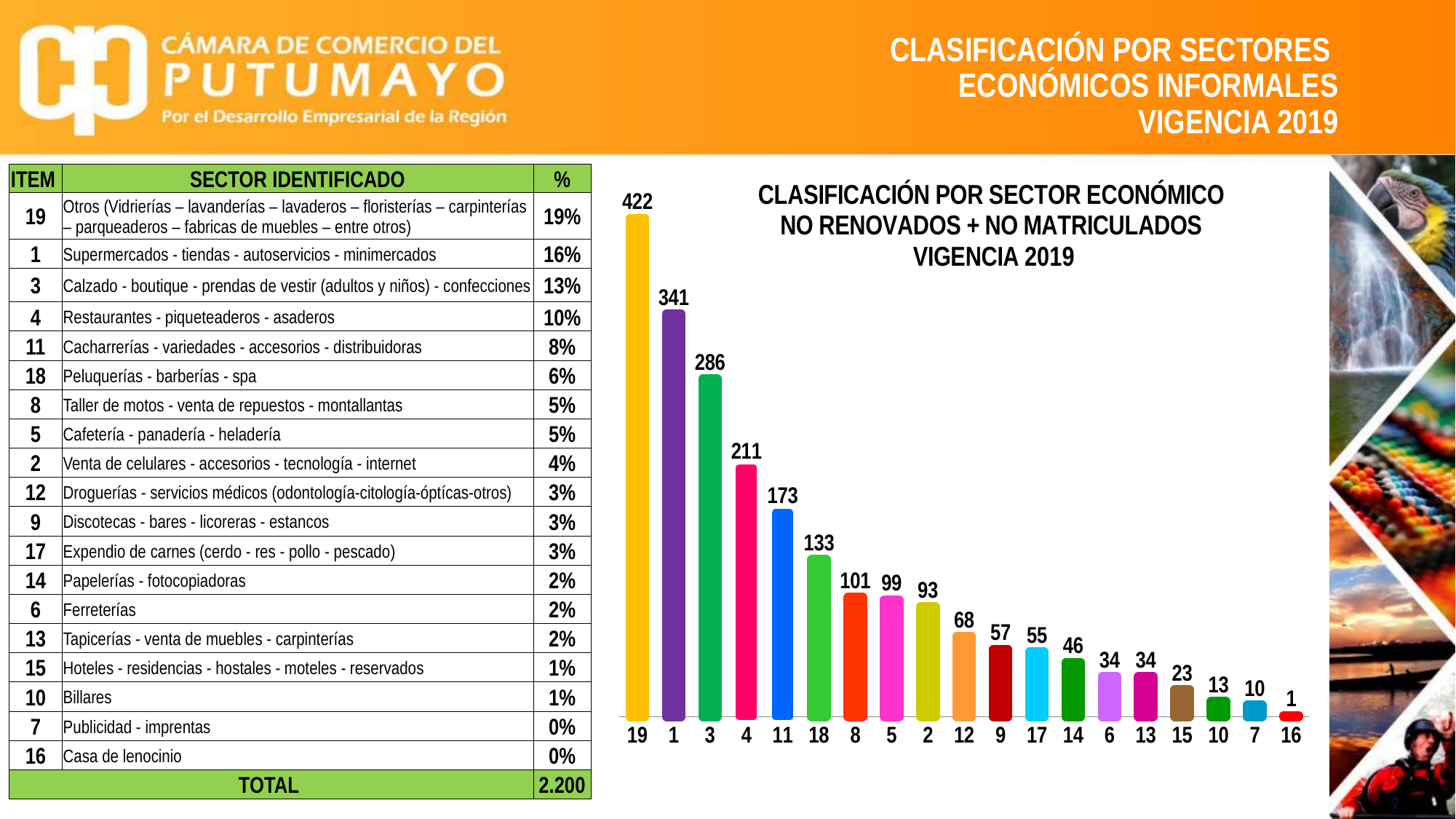
Which has a larger value, item 8 or item 5? item 8 Which item has the lowest bar in the chart? 16 Do the bar values rise or fall from left to right along the x axis? fall What is the value of the bar for item 11? 173 How many bars (categories) are plotted in the chart? 19 What is the title of the chart? CLASIFICACIÓN POR SECTOR ECONÓMICO NO RENOVADOS + NO MATRICULADOS VIGENCIA 2019 What type of chart is shown on the slide? bar chart What is the value of the bar for item 19? 422 Which item has the highest bar in the chart? 19 What is the difference between the values for item 3 and item 4? 75 What is the difference between the values for item 19 and item 1? 81 What is the value of the bar for item 12? 68